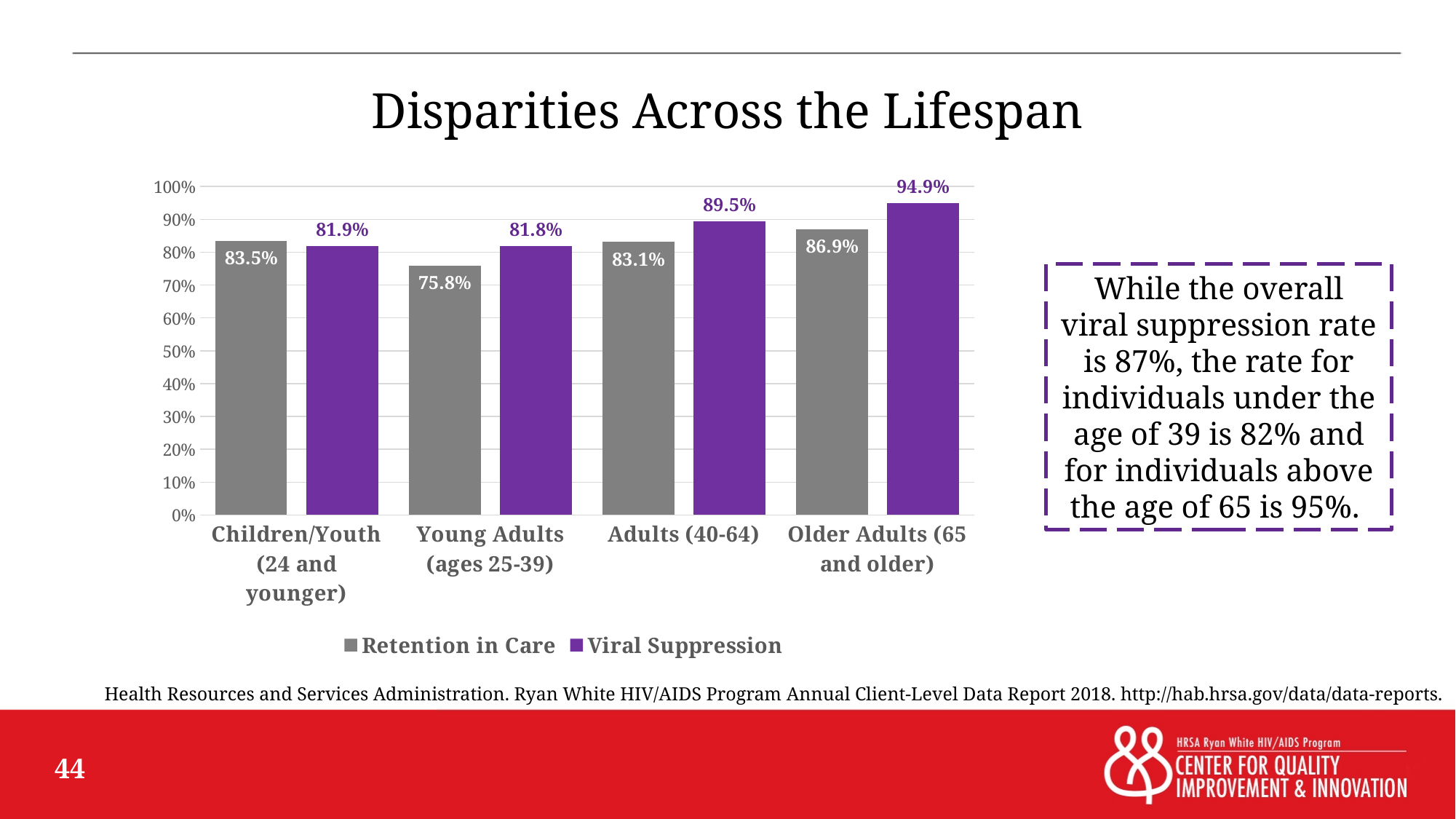
What is the Viral Suppression value for Adults (40-64)? 89.5% Which age group has the highest Viral Suppression value? Older Adults (65 and older) Is the Retention in Care value for Adults (40-64) greater or less than 80%? greater How many series does the legend list? 2 What is the Retention in Care value for Young Adults (ages 25-39)? 75.8% Which is larger for Young Adults (ages 25-39): Retention in Care or Viral Suppression? Viral Suppression What is the Viral Suppression value for Older Adults (65 and older)? 94.9% How many age groups are shown on the x axis? 4 Which age group has the lowest Retention in Care value? Young Adults (ages 25-39) What is the title of the chart on the slide? Disparities Across the Lifespan What kind of chart is shown on the slide? Bar chart What is the difference between the Viral Suppression and Retention in Care values for Older Adults (65 and older)? 8.0%